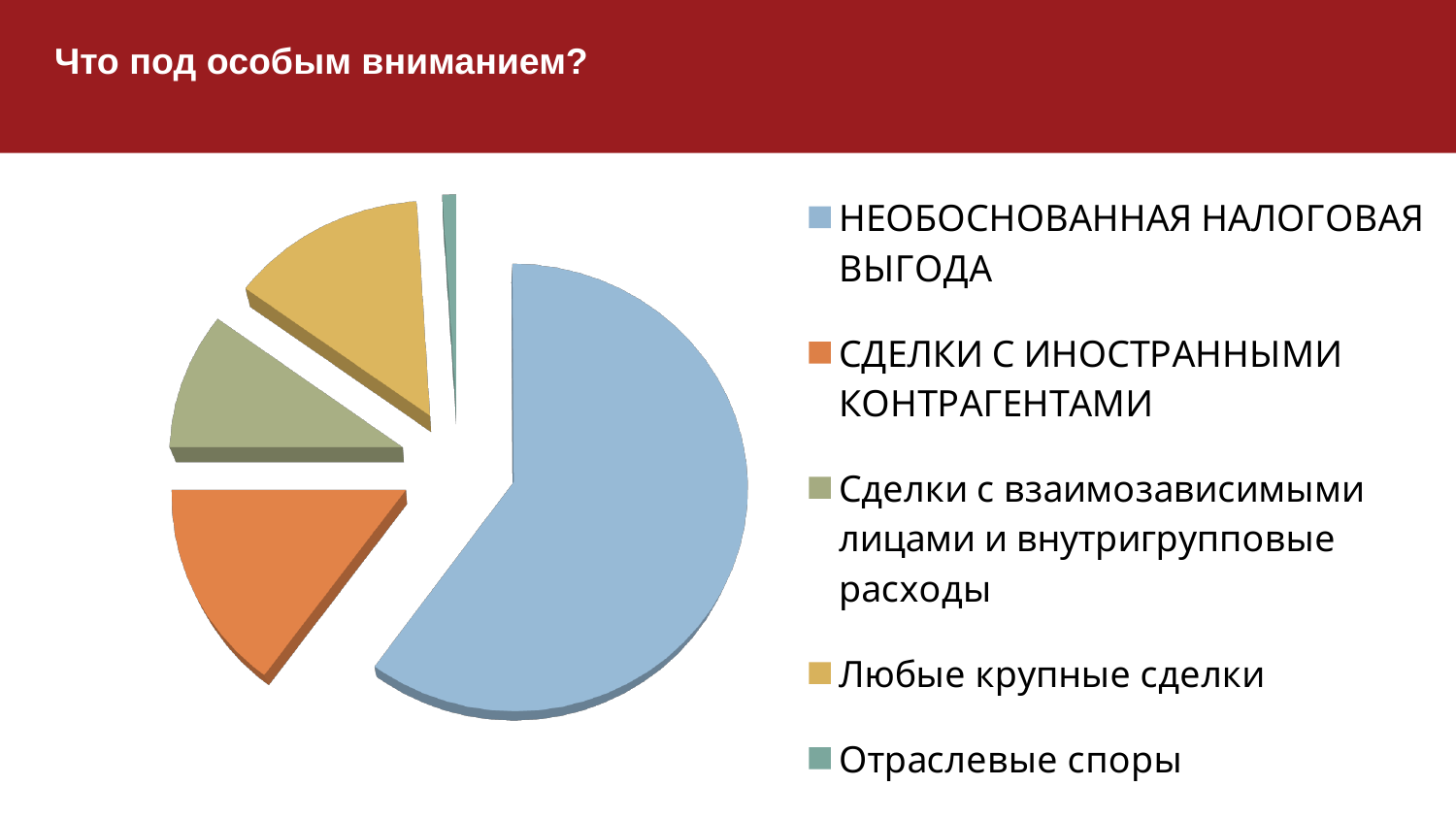
What colour is the slice for Любые крупные сделки? yellow Which category has the smallest slice of the pie chart? Отраслевые споры Which slice is larger: Отраслевые споры or Сделки с взаимозависимыми лицами и внутригрупповые расходы? Сделки с взаимозависимыми лицами и внутригрупповые расходы What kind of chart is shown on the slide? pie chart Which category has the largest slice of the pie chart? НЕОБОСНОВАННАЯ НАЛОГОВАЯ ВЫГОДА Does the largest slice of the pie chart account for more or less than half of the pie? more How many slices does the pie chart have? 5 Which slice is larger: Любые крупные сделки or Отраслевые споры? Любые крупные сделки How many entries does the legend of the pie chart list? 5 What is the title of the slide containing the pie chart? Что под особым вниманием?